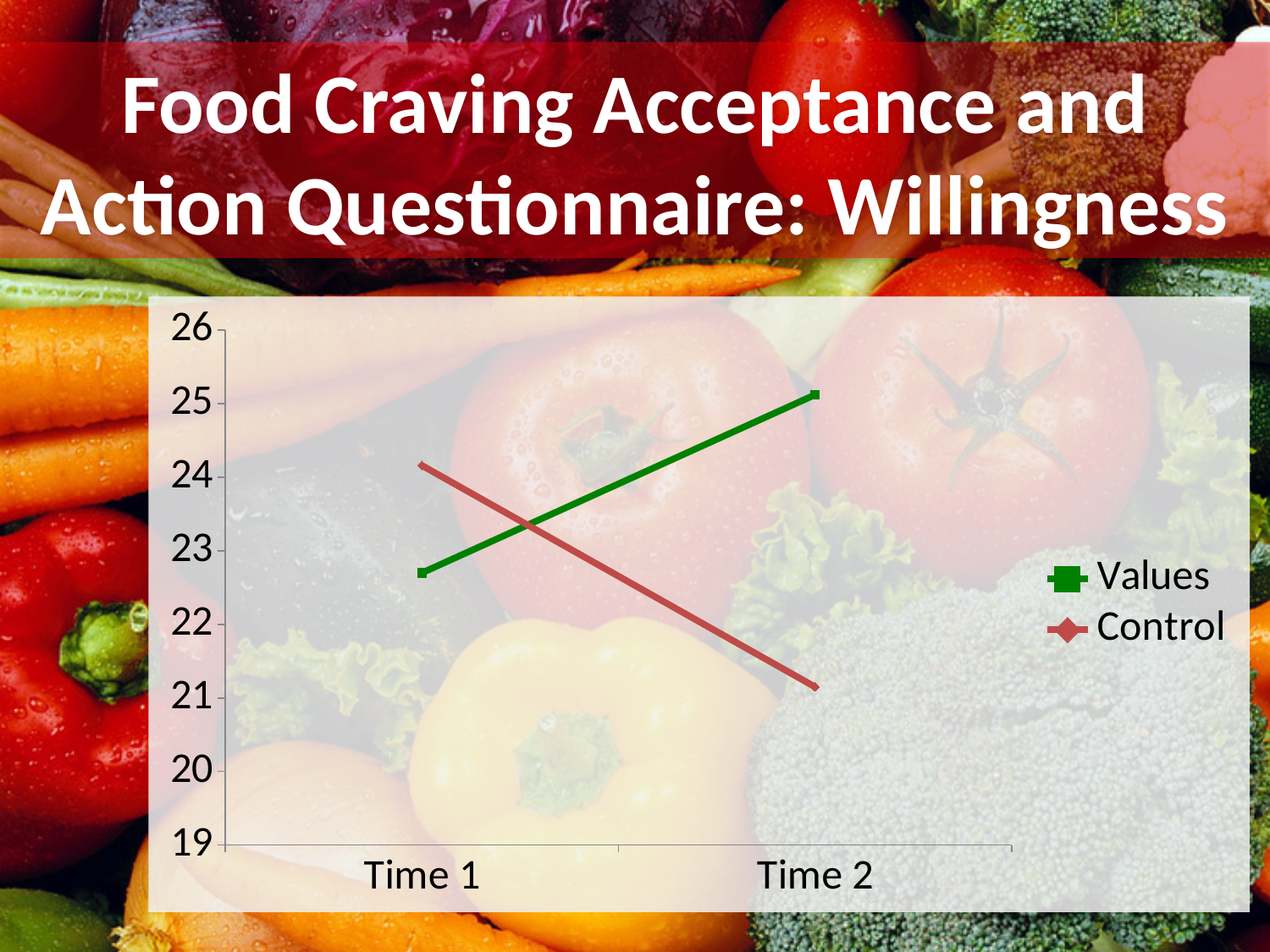
Is the value for the Control series at Time 1 greater or less than 23? greater At Time 2, which series has the higher value, Values or Control? Values Is the value for the Values series at Time 2 greater or less than 24? greater At Time 1, which series has the higher value, Values or Control? Control Is the value for the Values series at Time 1 greater or less than 22? greater Which colour is used for the Values series line? green What kind of chart is shown on the slide? line chart Does the Control series rise or fall from Time 1 to Time 2? fall How many series does the legend list? 2 How many time points are shown on the x axis? 2 Does the Values series rise or fall from Time 1 to Time 2? rise